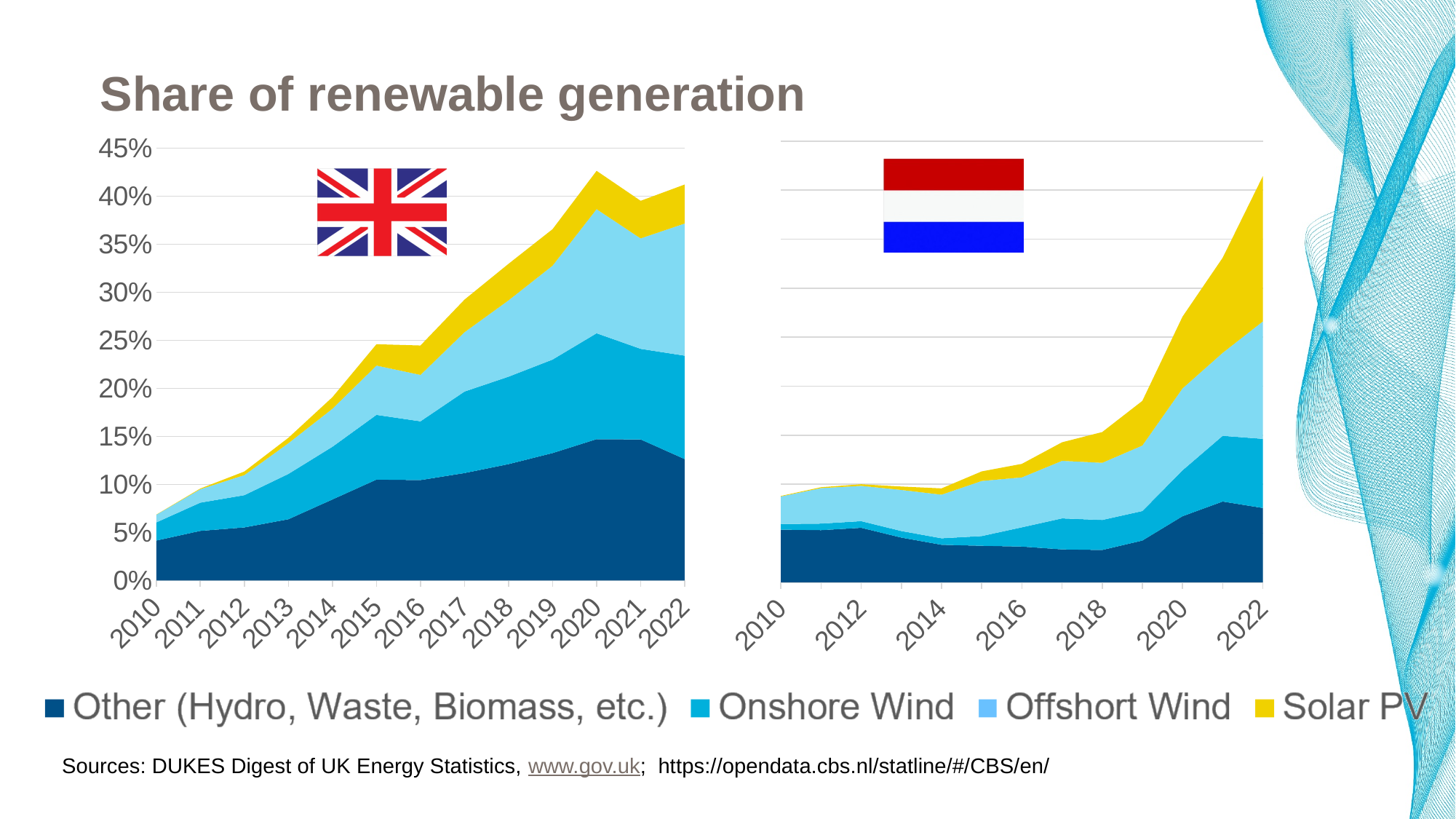
In the left chart (UK), is the total share of renewable generation in 2015 greater or less than 20%? greater What kind of chart is the left chart (UK)? stacked area chart In the right chart (Netherlands), does the total share of renewable generation rise or fall from 2010 to 2022? rise In the left chart (UK), is the total share of renewable generation in 2020 greater or less than 40%? greater How many years are plotted along the x axis of the left chart (UK)? 13 In the left chart (UK), is the total share of renewable generation in 2010 greater or less than 10%? less Which colour represents Solar PV in the legend? yellow How many series does the legend list? 4 Which is larger in 2016: the total renewable share in the left chart (UK) or in the right chart (Netherlands)? UK Which year has the highest total share of renewable generation in the right chart (Netherlands)? 2022